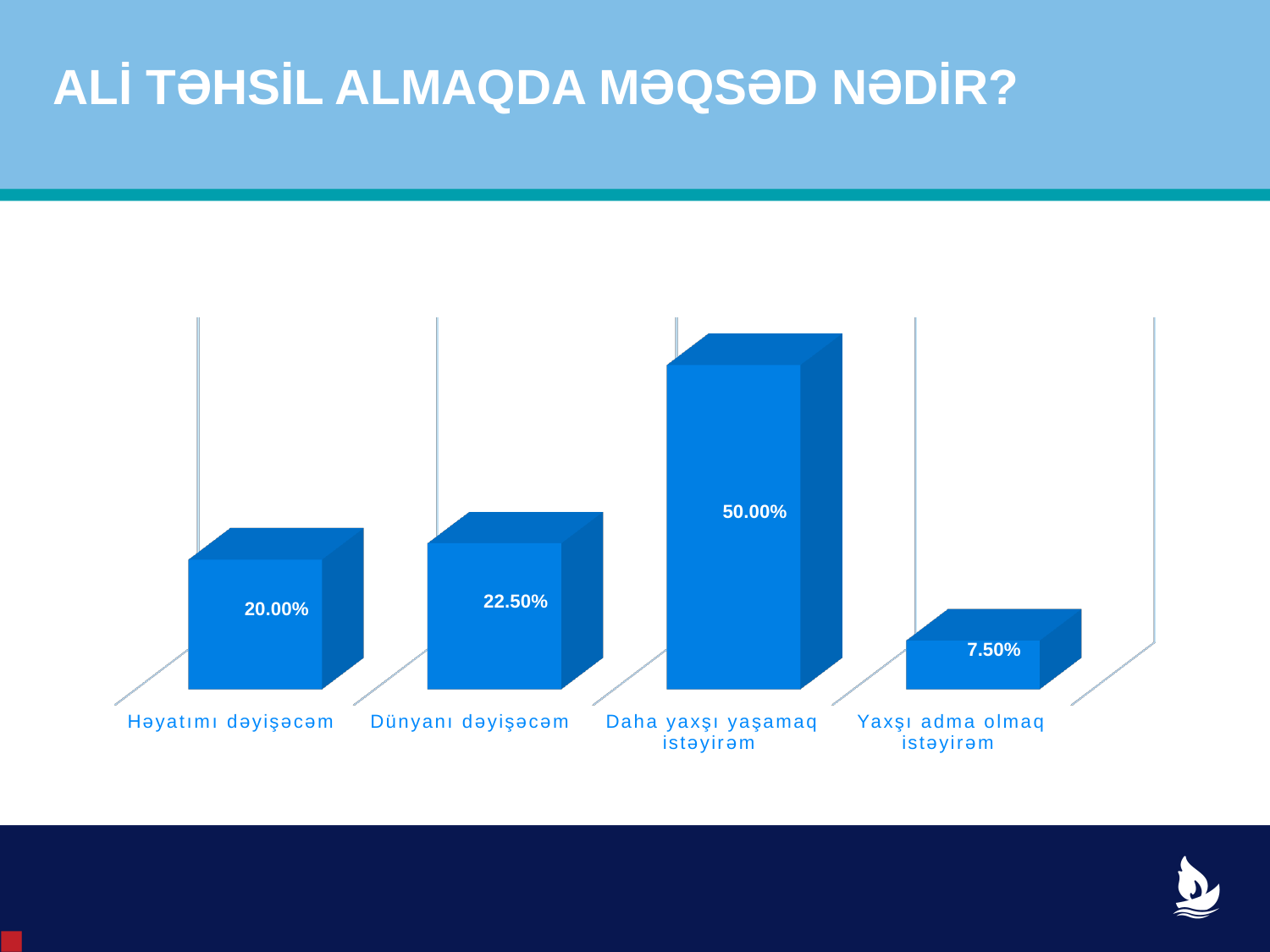
What is the value for "Daha yaxşı yaşamaq istəyirəm"? 50.00% What is the title of the slide? ALİ TƏHSİL ALMAQDA MƏQSƏD NƏDİR? What kind of chart is shown on the slide? Bar chart Which category has the highest value? Daha yaxşı yaşamaq istəyirəm What is the value for "Yaxşı adma olmaq istəyirəm"? 7.50% What is the difference between the values for "Daha yaxşı yaşamaq istəyirəm" and "Həyatımı dəyişəcəm"? 30.00% What is the difference between the values for "Dünyanı dəyişəcəm" and "Yaxşı adma olmaq istəyirəm"? 15.00% How many categories are shown in the chart? 4 Which category has the lowest value? Yaxşı adma olmaq istəyirəm Which is larger, the value for "Dünyanı dəyişəcəm" or the value for "Həyatımı dəyişəcəm"? Dünyanı dəyişəcəm What is the value for "Dünyanı dəyişəcəm"? 22.50% What is the value for "Həyatımı dəyişəcəm"? 20.00%